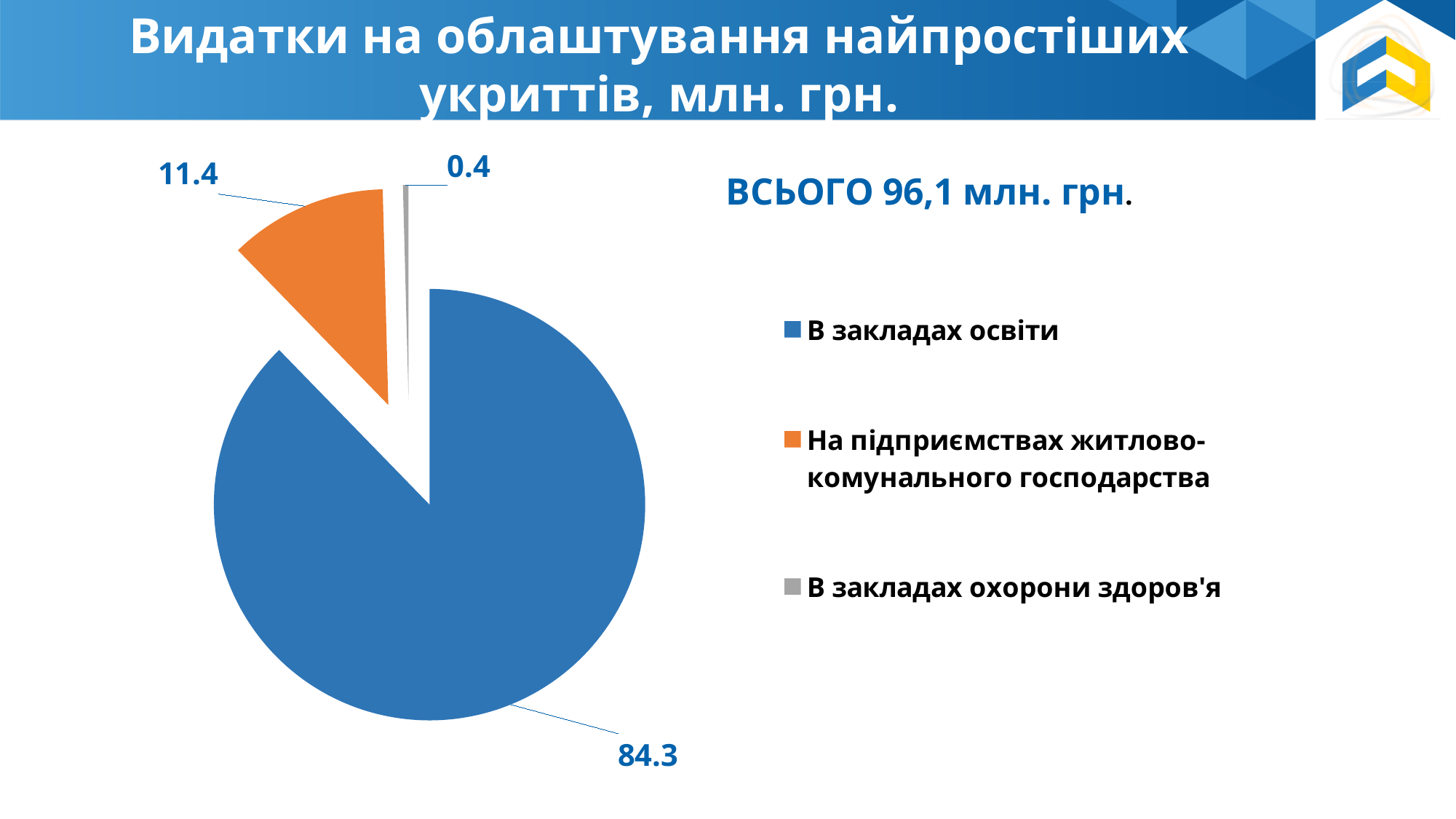
What is the value for 'В закладах охорони здоров'я'? 0.4 What is the difference between the values for 'В закладах освіти' and 'На підприємствах житлово-комунального господарства'? 72.9 Which category has the smallest slice of the pie? В закладах охорони здоров'я What colour is the slice for 'На підприємствах житлово-комунального господарства'? Orange Which category has the largest slice of the pie? В закладах освіти What is the value for 'В закладах освіти'? 84.3 What is the title of the chart on the slide? Видатки на облаштування найпростіших укриттів, млн. грн. Which is larger: the value for 'На підприємствах житлово-комунального господарства' or for 'В закладах охорони здоров'я'? На підприємствах житлово-комунального господарства How many categories does the pie chart have? 3 What is the value for 'На підприємствах житлово-комунального господарства'? 11.4 What is the total of all slices in the pie chart? 96.1 What type of chart is shown on the slide? Pie chart